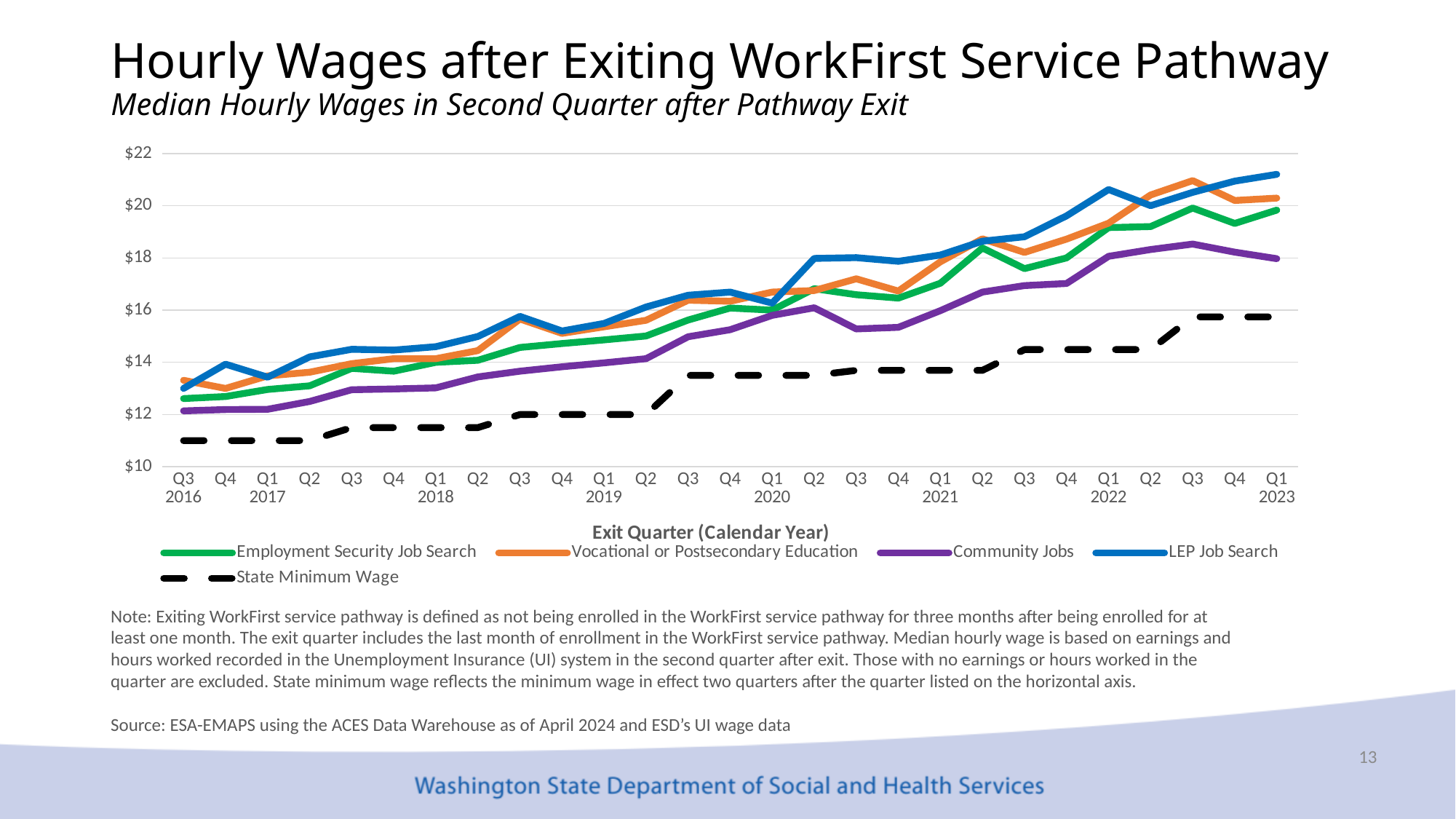
Do median hourly wages generally rise or fall from Q3 2016 to Q1 2023? Rise Is the value for State Minimum Wage in Q1 2023 greater or less than $16? less How many exit quarters are plotted along the x axis? 27 Is the value for State Minimum Wage in Q3 2016 greater or less than $12? less What is the label of the x axis? Exit Quarter (Calendar Year) In Q3 2022, which is larger: Vocational or Postsecondary Education or Employment Security Job Search? Vocational or Postsecondary Education Is the value for Employment Security Job Search in Q1 2023 greater or less than $20? less Which of the four service pathways has the lowest median hourly wage in Q1 2023? Community Jobs Which series has the highest value in Q1 2023? LEP Job Search How many series does the legend list? 5 What kind of chart is shown on the slide? Line chart